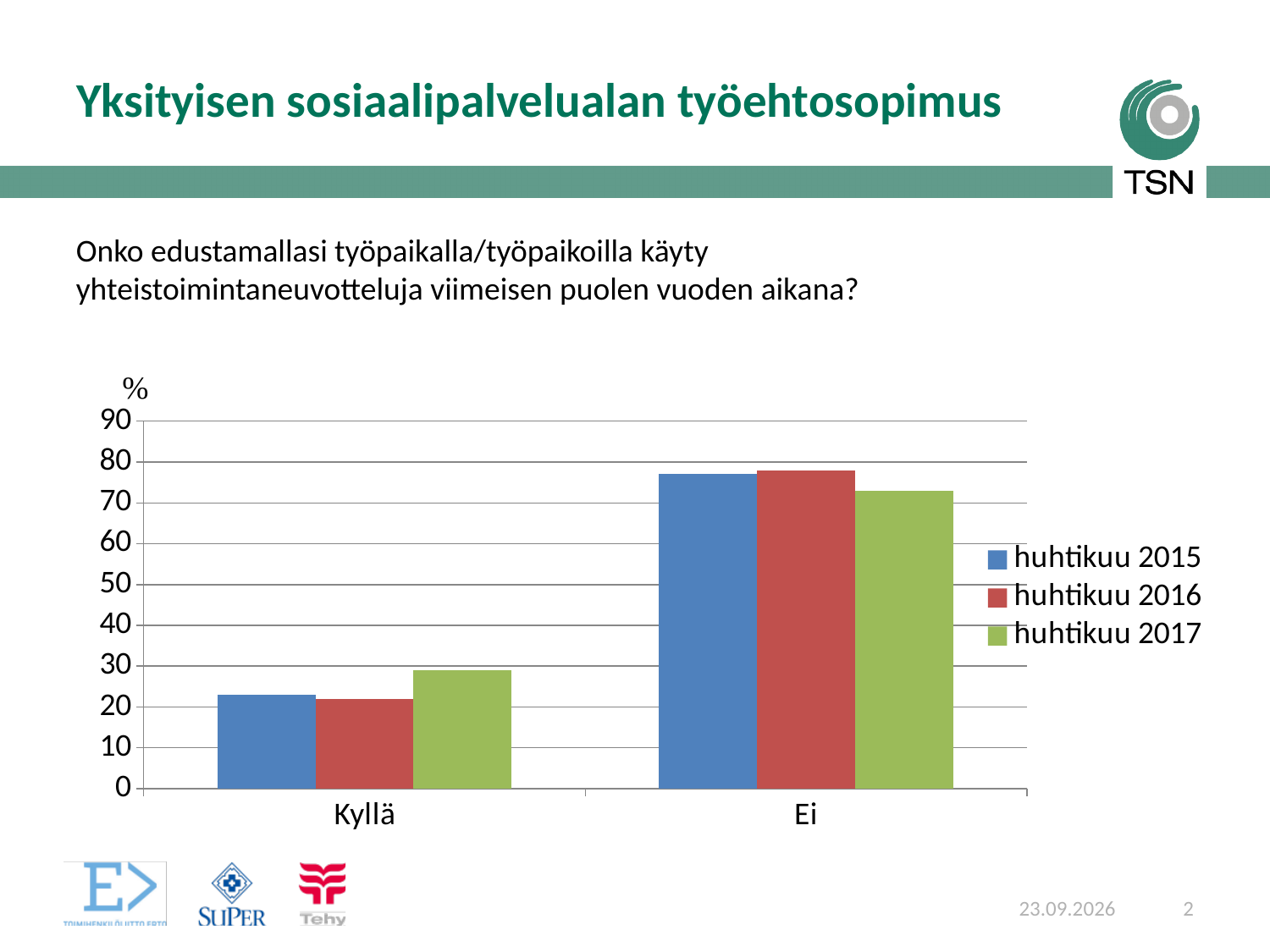
For huhtikuu 2017, which category has the larger value, Kyllä or Ei? Ei Which series has the lowest value for Ei? huhtikuu 2017 How many series does the legend list? 3 For Kyllä, which is larger, the value for huhtikuu 2015 or huhtikuu 2017? huhtikuu 2017 Which series has the highest value for Kyllä? huhtikuu 2017 Is the value for Ei in huhtikuu 2016 greater or less than 70? greater Is the value for Kyllä in huhtikuu 2017 greater or less than 20? greater Is the value for Kyllä in huhtikuu 2015 greater or less than 30? less What unit is shown on the y axis of the chart? % What kind of chart is shown on the slide? bar chart How many categories are shown on the x axis? 2